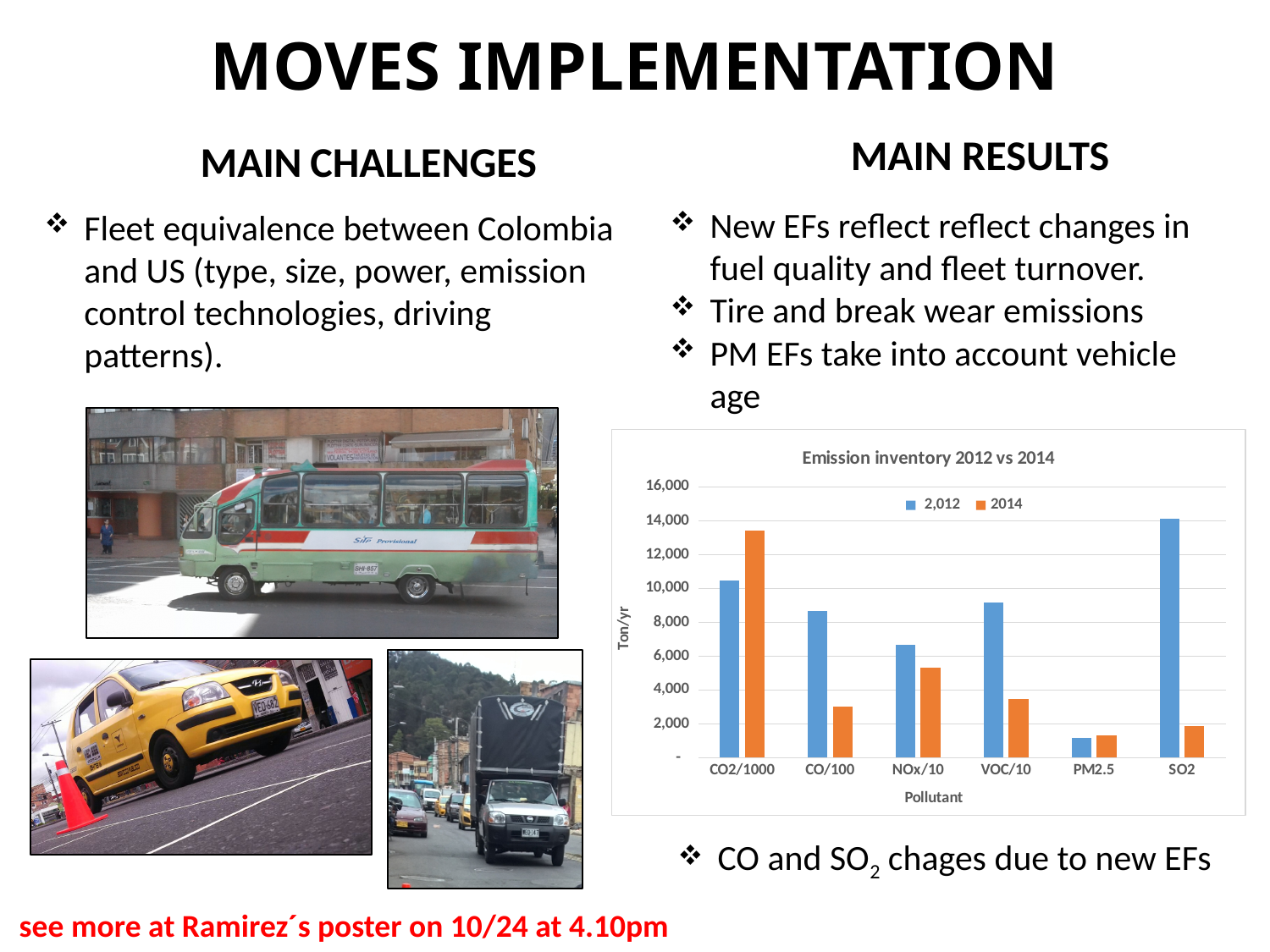
Which pollutant has the lowest value for the 2014 series? PM2.5 How many series does the chart legend list? 2 For CO2/1000, which series has the larger value, 2,012 or 2014? 2014 How many pollutant categories are shown on the x axis of the chart? 6 Is the 2,012 value for SO2 greater or less than 12,000? greater Is the 2014 value for CO/100 greater or less than 4,000? less What is the title of the chart? Emission inventory 2012 vs 2014 What kind of chart is shown on the slide? bar chart Which pollutant has the highest value for the 2014 series? CO2/1000 Which pollutant has the lowest value for the 2,012 series? PM2.5 Which pollutant has the highest value for the 2,012 series? SO2 For SO2, which series has the larger value, 2,012 or 2014? 2,012